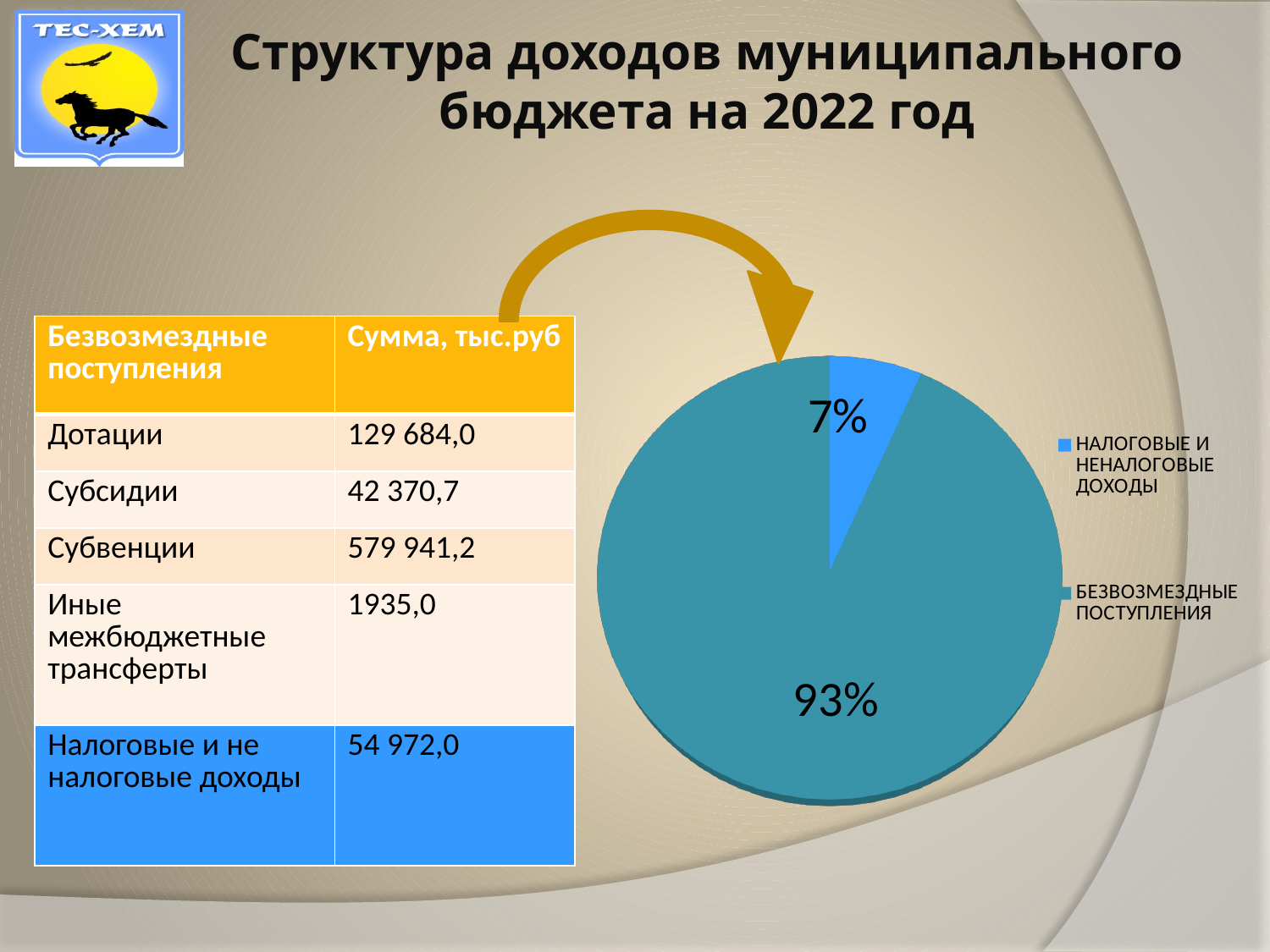
Which slice of the pie chart is the smallest? НАЛОГОВЫЕ И НЕНАЛОГОВЫЕ ДОХОДЫ What share of the pie does НАЛОГОВЫЕ И НЕНАЛОГОВЫЕ ДОХОДЫ take? 7% What is the difference in percentage points between the БЕЗВОЗМЕЗДНЫЕ ПОСТУПЛЕНИЯ slice and the НАЛОГОВЫЕ И НЕНАЛОГОВЫЕ ДОХОДЫ slice? 86 percentage points How many slices does the pie chart have? 2 What colour is the НАЛОГОВЫЕ И НЕНАЛОГОВЫЕ ДОХОДЫ slice in the pie chart? light blue Which is larger in the pie chart: НАЛОГОВЫЕ И НЕНАЛОГОВЫЕ ДОХОДЫ or БЕЗВОЗМЕЗДНЫЕ ПОСТУПЛЕНИЯ? БЕЗВОЗМЕЗДНЫЕ ПОСТУПЛЕНИЯ What kind of chart is shown on the slide? pie chart Which slice of the pie chart is the largest? БЕЗВОЗМЕЗДНЫЕ ПОСТУПЛЕНИЯ How many entries does the pie chart's legend list? 2 What is the title of the slide containing the pie chart? Структура доходов муниципального бюджета на 2022 год What share of the pie does БЕЗВОЗМЕЗДНЫЕ ПОСТУПЛЕНИЯ take? 93%